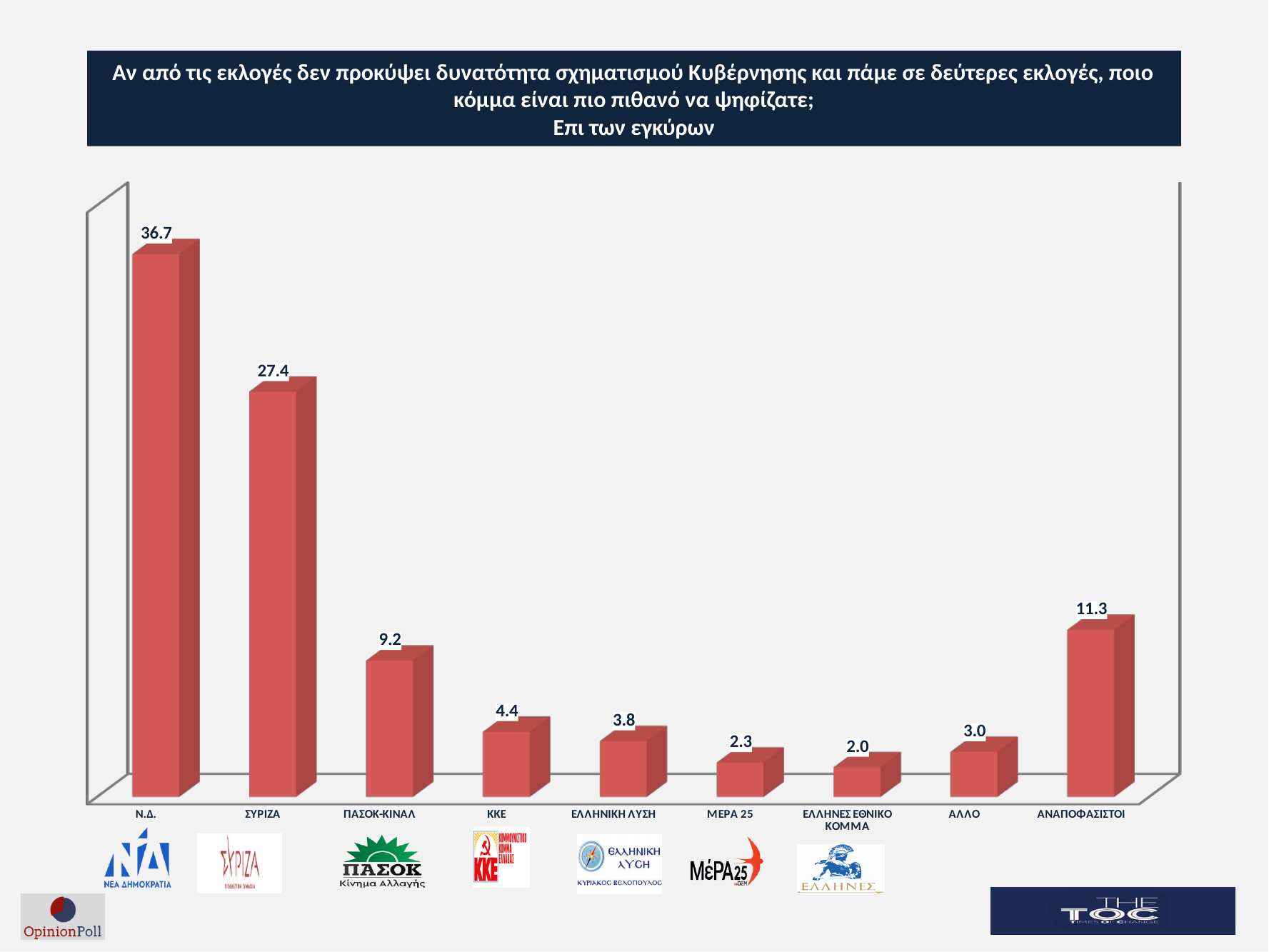
What is the value for ΠΑΣΟΚ-ΚΙΝΑΛ? 9.2 What kind of chart is shown on the slide? bar chart What is the value for ΕΛΛΗΝΕΣ ΕΘΝΙΚΟ ΚΟΜΜΑ? 2.0 Which category has the lowest value? ΕΛΛΗΝΕΣ ΕΘΝΙΚΟ ΚΟΜΜΑ What is the value for Ν.Δ.? 36.7 What is the value for ΣΥΡΙΖΑ? 27.4 How many categories are shown on the chart? 9 Which is larger, the value for ΚΚΕ or the value for ΕΛΛΗΝΙΚΗ ΛΥΣΗ? ΚΚΕ What is the difference between the values for ΑΝΑΠΟΦΑΣΙΣΤΟΙ and ΑΛΛΟ? 8.3 What is the value for ΑΝΑΠΟΦΑΣΙΣΤΟΙ? 11.3 What is the difference between the values for Ν.Δ. and ΣΥΡΙΖΑ? 9.3 Which category has the highest value? Ν.Δ.